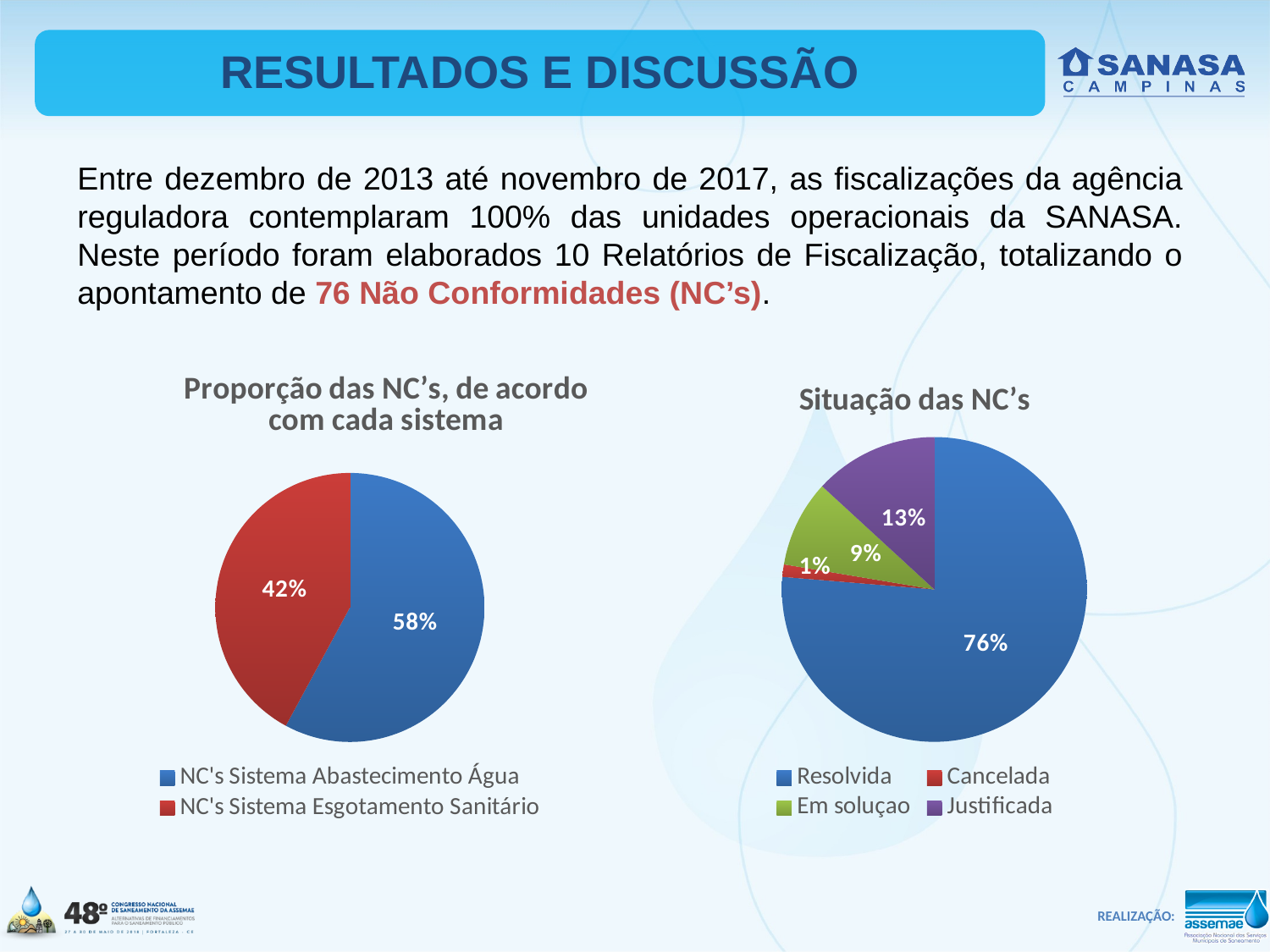
In the chart titled "Situação das NC's", what share is labelled for Justificada? 13% In the chart titled "Situação das NC's", how many categories does the legend list? 4 In the chart titled "Situação das NC's", which category has the smallest slice? Cancelada In the chart titled "Situação das NC's", what share is labelled for Em soluçao? 9% In the chart titled "Proporção das NC's, de acordo com cada sistema", which category has the larger slice? NC's Sistema Abastecimento Água In the chart titled "Proporção das NC's, de acordo com cada sistema", what share is labelled for NC's Sistema Esgotamento Sanitário? 42% In the chart titled "Situação das NC's", what colour is the Resolvida slice? Blue In the chart titled "Situação das NC's", which is larger, Justificada or Em soluçao? Justificada In the chart titled "Proporção das NC's, de acordo com cada sistema", what is the difference in percentage points between the two slices? 16 What kind of chart is the chart titled "Situação das NC's"? Pie chart